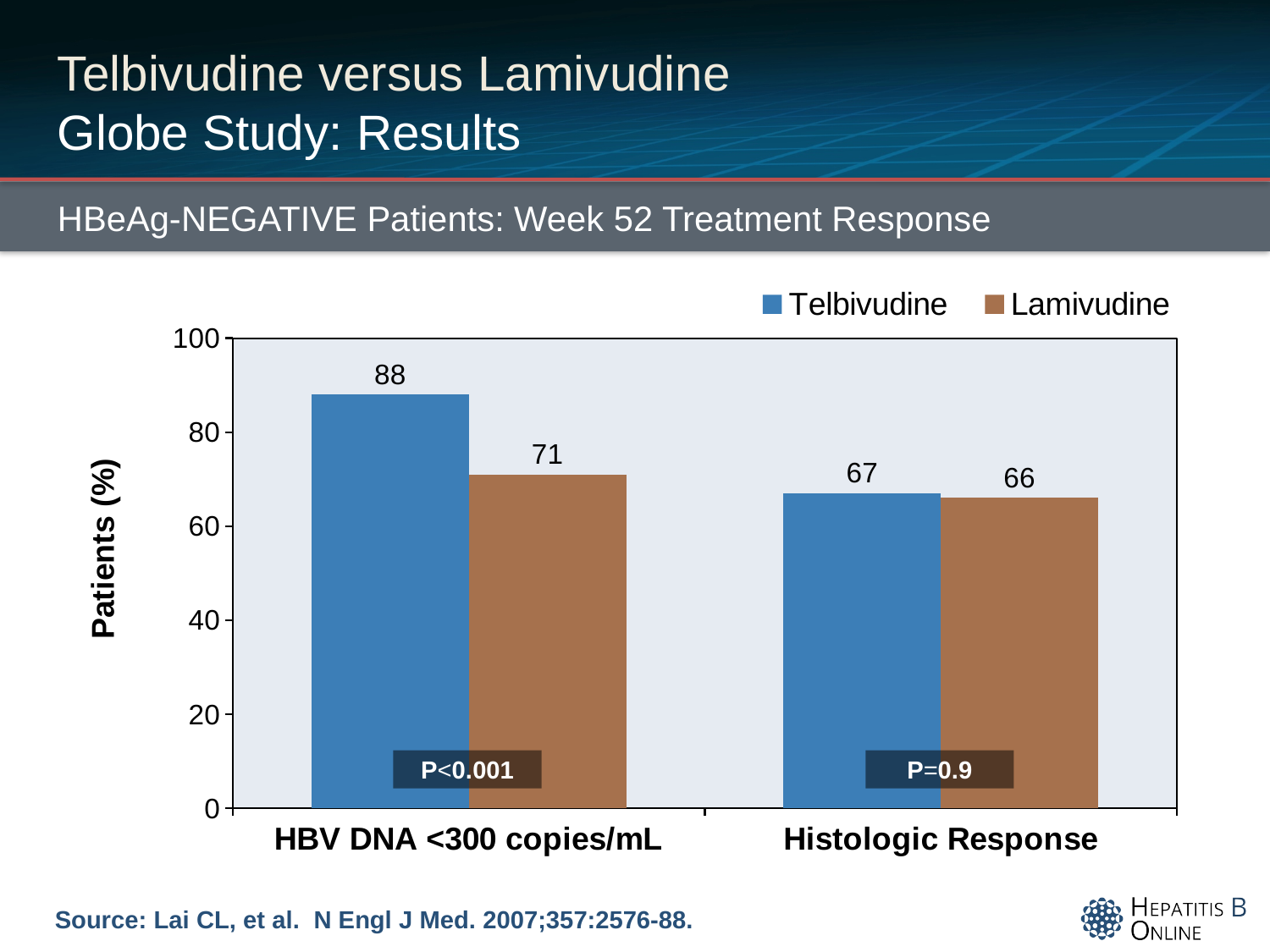
What is the difference between Telbivudine and Lamivudine in the Histologic Response category? 1 How many categories are shown on the x axis? 2 What is the value for Lamivudine in the Histologic Response category? 66 Which bar has the highest value on the chart? Telbivudine, HBV DNA <300 copies/mL What is the value for Telbivudine in the Histologic Response category? 67 What is the difference between Telbivudine and Lamivudine in the HBV DNA <300 copies/mL category? 17 What kind of chart is shown on the slide? Bar chart What is the value for Telbivudine in the HBV DNA <300 copies/mL category? 88 In the HBV DNA <300 copies/mL category, which series has the larger value, Telbivudine or Lamivudine? Telbivudine What is the value for Lamivudine in the HBV DNA <300 copies/mL category? 71 How many series does the legend list? 2 What is the label of the y axis? Patients (%)